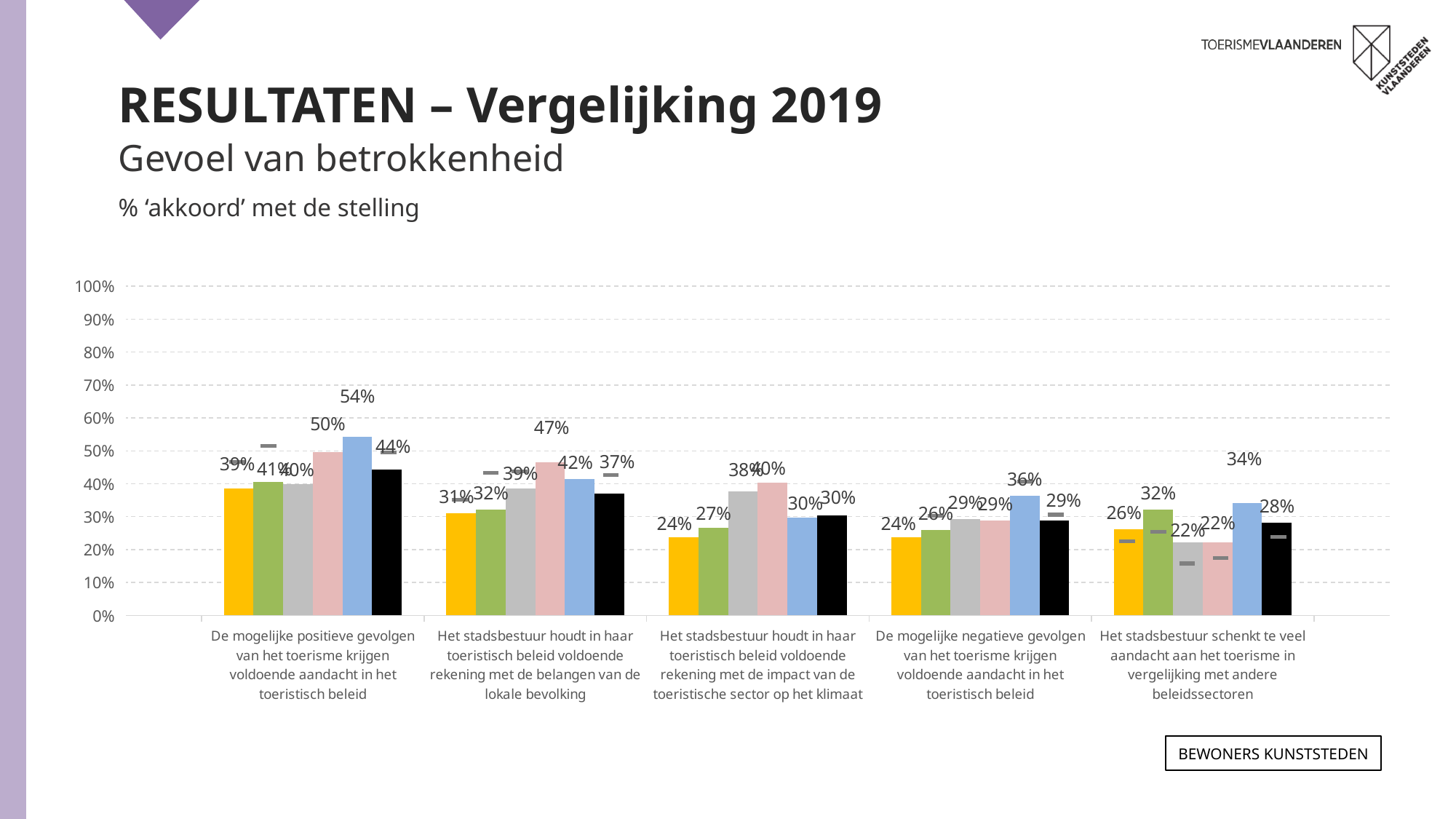
Which statement has the highest value of any bar in the chart? De mogelijke positieve gevolgen van het toerisme krijgen voldoende aandacht in het toeristisch beleid For 'De mogelijke positieve gevolgen van het toerisme krijgen voldoende aandacht in het toeristisch beleid', what is the difference between the blue bar and the yellow bar? 15 percentage points For 'De mogelijke negatieve gevolgen van het toerisme krijgen voldoende aandacht in het toeristisch beleid', what is the difference between the blue bar and the yellow bar? 12 percentage points What is the value of the yellow bar for 'Het stadsbestuur schenkt te veel aandacht aan het toerisme in vergelijking met andere beleidssectoren'? 26% How many statements (categories) are shown along the x axis of the chart? 5 What is the value of the pink bar for 'Het stadsbestuur houdt in haar toeristisch beleid voldoende rekening met de belangen van de lokale bevolking'? 47% What is the value of the blue bar for 'De mogelijke positieve gevolgen van het toerisme krijgen voldoende aandacht in het toeristisch beleid'? 54% What is the value of the black bar for 'Het stadsbestuur schenkt te veel aandacht aan het toerisme in vergelijking met andere beleidssectoren'? 28% Is the value of the yellow bar for 'Het stadsbestuur houdt in haar toeristisch beleid voldoende rekening met de impact van de toeristische sector op het klimaat' greater or less than 30%? less For 'Het stadsbestuur houdt in haar toeristisch beleid voldoende rekening met de impact van de toeristische sector op het klimaat', which is larger: the pink bar or the blue bar? the pink bar What is the lowest value shown for 'Het stadsbestuur schenkt te veel aandacht aan het toerisme in vergelijking met andere beleidssectoren'? 22% What kind of chart is shown on the slide? bar chart